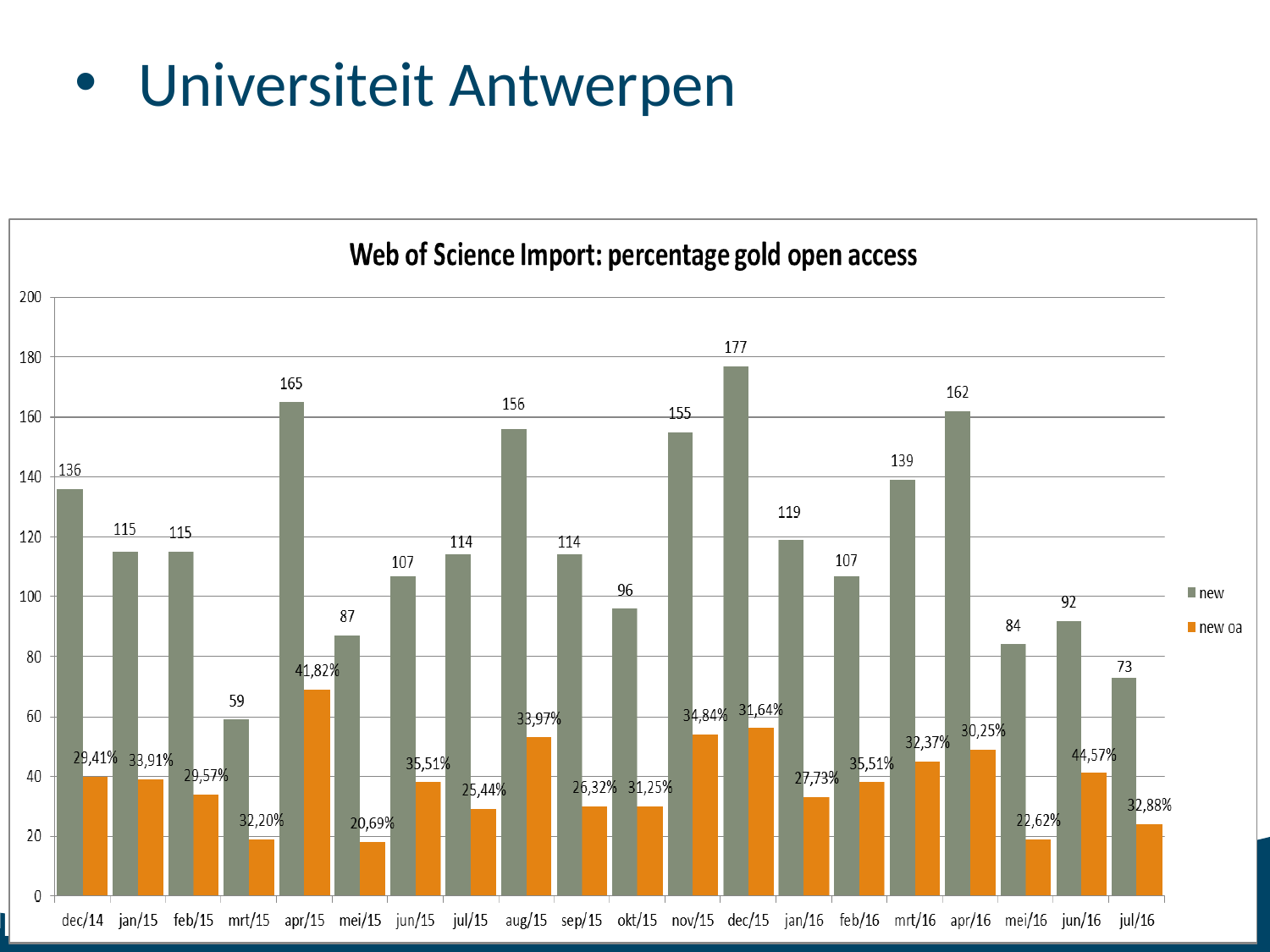
What is the title of the chart? Web of Science Import: percentage gold open access What kind of chart is shown? bar chart Is the 'new oa' bar for apr/15 greater or less than 60? greater What is the value of the 'new' series for dec/15? 177 What is the value of the 'new' series for mrt/15? 59 Which month has the highest value in the 'new' series? dec/15 How many series does the legend list? 2 What percentage label is shown on the 'new oa' bar for apr/15? 41,82% Which month has the lowest value in the 'new' series? mrt/15 What is the difference between the highest and lowest 'new' values (dec/15 and mrt/15)? 118 Which month has a larger 'new' value, apr/15 or aug/15? apr/15 How many months are shown on the x axis? 20